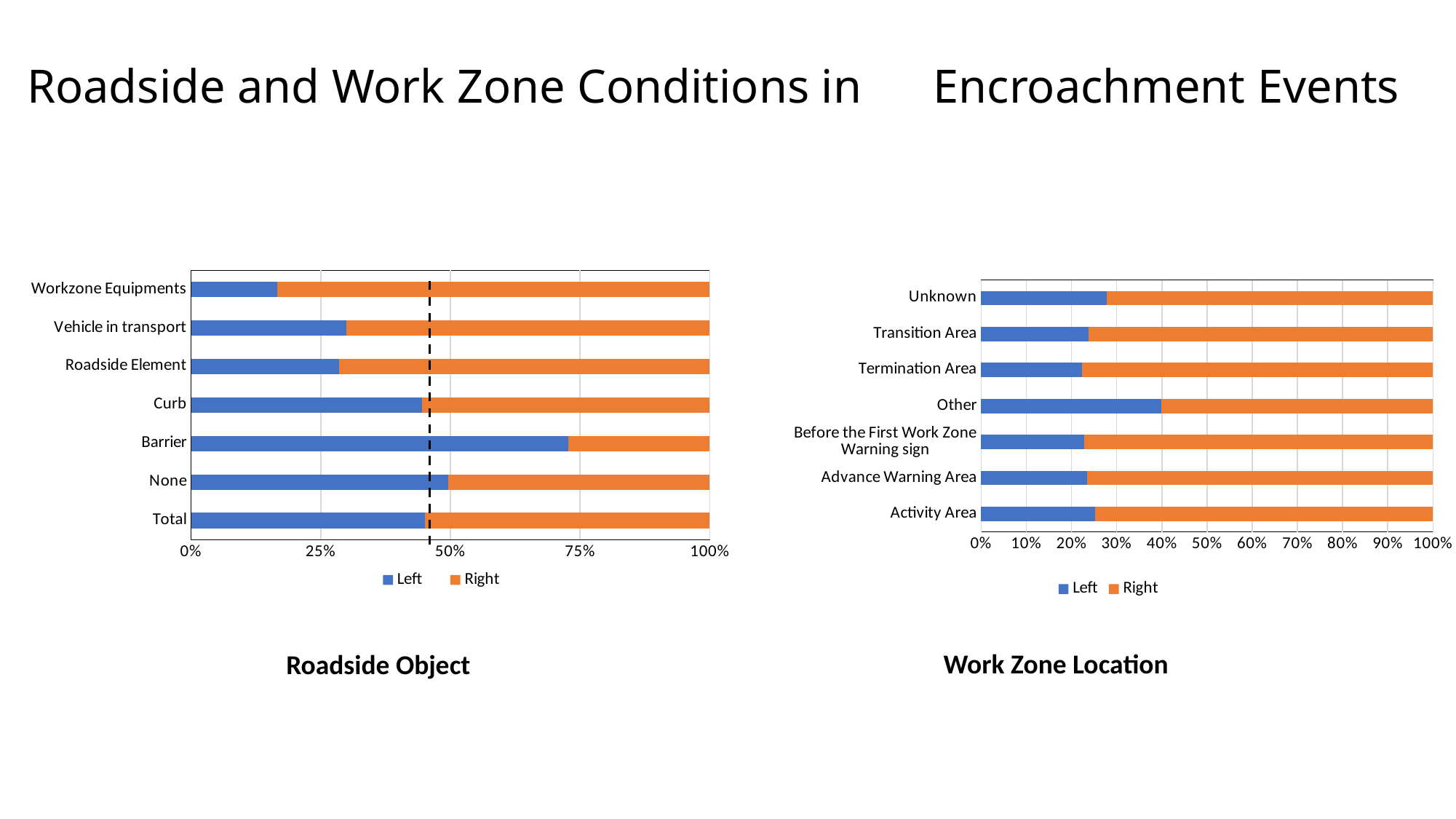
On the Roadside Object chart, which category has the largest Left share? Barrier On the Work Zone Location chart, which has the larger Left share, Other or Unknown? Other On the Roadside Object chart, is the Left share for Barrier greater or less than 50%? greater How many series does the legend of the Work Zone Location chart list? 2 On the Roadside Object chart, is the Left share for Workzone Equipments greater or less than 25%? less What kind of chart is the Roadside Object chart? stacked bar chart How many categories are shown on the Roadside Object chart? 7 On the Work Zone Location chart, is the Left share for Unknown greater or less than 20%? greater On the Work Zone Location chart, which category has the largest Left share? Other On the Roadside Object chart, which category has the smallest Left share? Workzone Equipments What colour represents the Right series in the Work Zone Location chart? orange